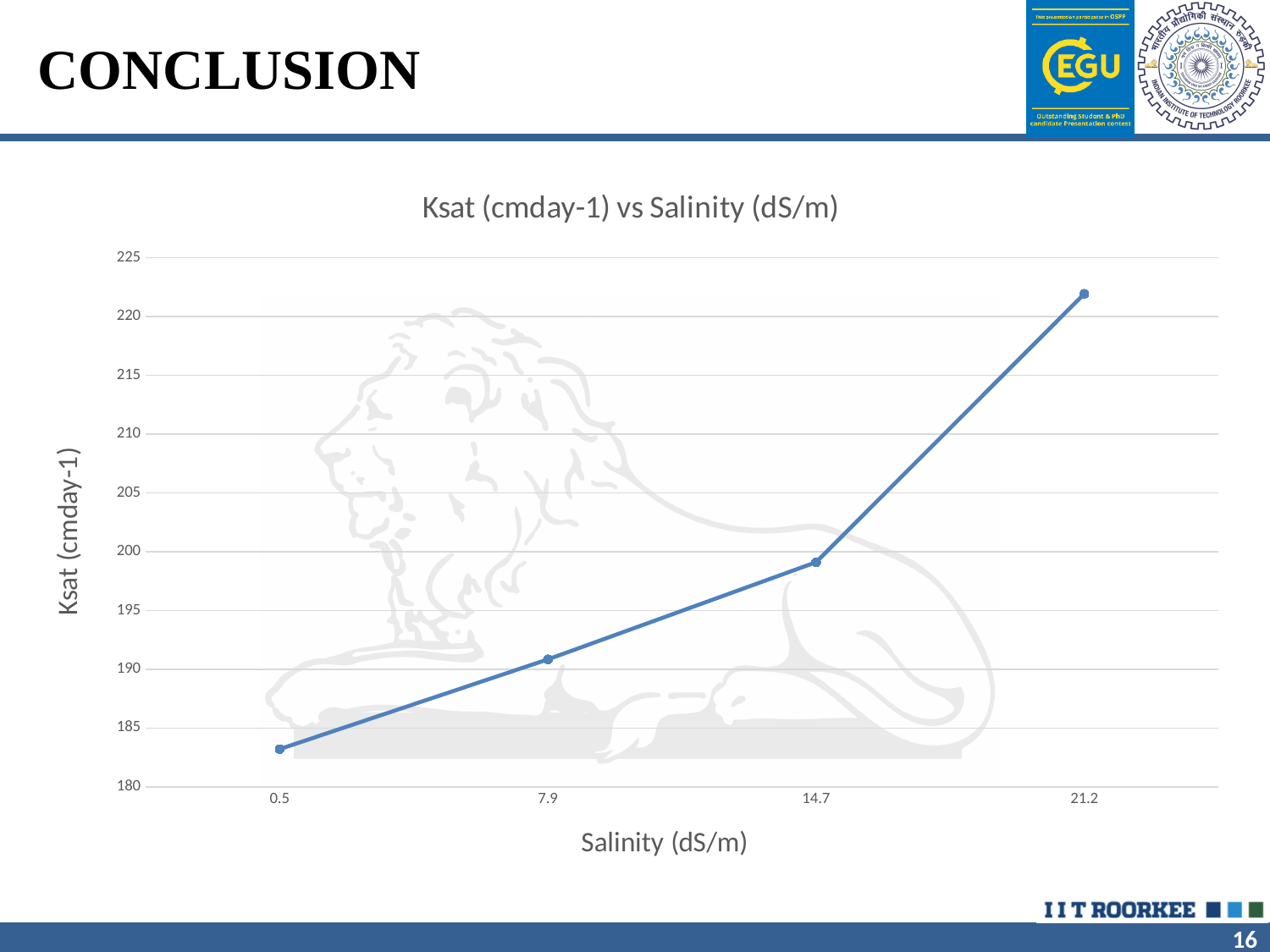
What is the title of the chart? Ksat (cmday-1) vs Salinity (dS/m) Is the Ksat value at salinity 21.2 greater or less than 220? greater Is the Ksat value at salinity 14.7 greater or less than 195? greater Is the Ksat value at salinity 0.5 greater or less than 185? less Which salinity value has the highest Ksat? 21.2 Which has a larger Ksat value, salinity 7.9 or salinity 14.7? 14.7 How many data points are plotted on the line? 4 What is the label of the x axis? Salinity (dS/m) Do the Ksat values rise or fall as salinity increases along the x axis? rise Which salinity value has the lowest Ksat? 0.5 What kind of chart is shown on the slide? line chart